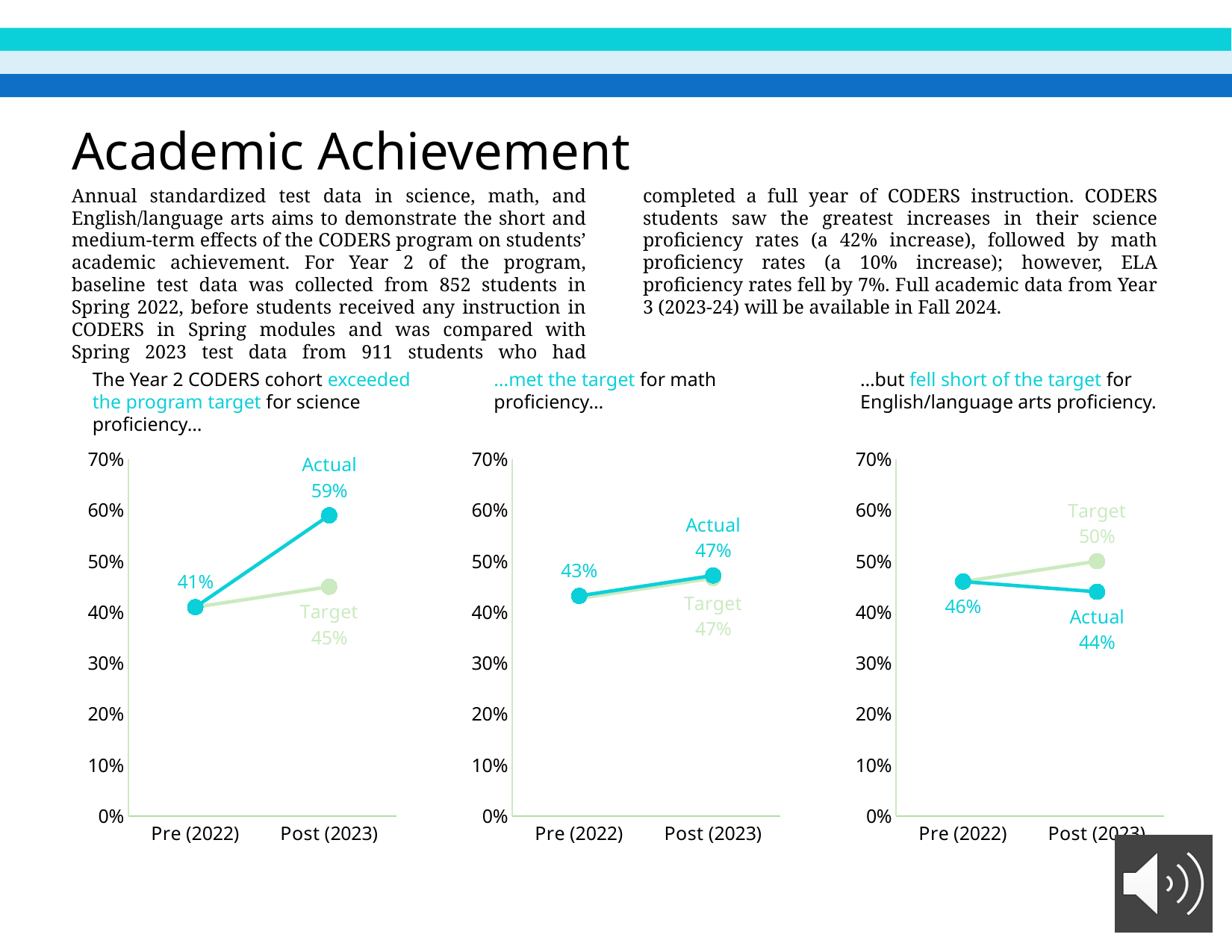
What type of chart is used on this slide? Line chart How many charts are shown on the slide? 3 In the left chart (science proficiency), what is the Target value for Post (2023)? 45% In the left chart (science proficiency), what is the Actual value for Post (2023)? 59% In the left chart (science proficiency), by how many percentage points does the Post (2023) Actual value exceed the Target? 14 percentage points In the right chart (English/language arts proficiency), does the Actual line rise or fall from Pre (2022) to Post (2023)? Fall In the middle chart (math proficiency), what is the Actual value for Post (2023)? 47% In the right chart (English/language arts proficiency), what is the Actual value for Post (2023)? 44% In the right chart (English/language arts proficiency), what is the Target value for Post (2023)? 50% In the right chart (English/language arts proficiency), which is larger at Post (2023), the Target or the Actual value? Target In the left chart (science proficiency), what is the value for Pre (2022)? 41% In the middle chart (math proficiency), what is the value for Pre (2022)? 43%